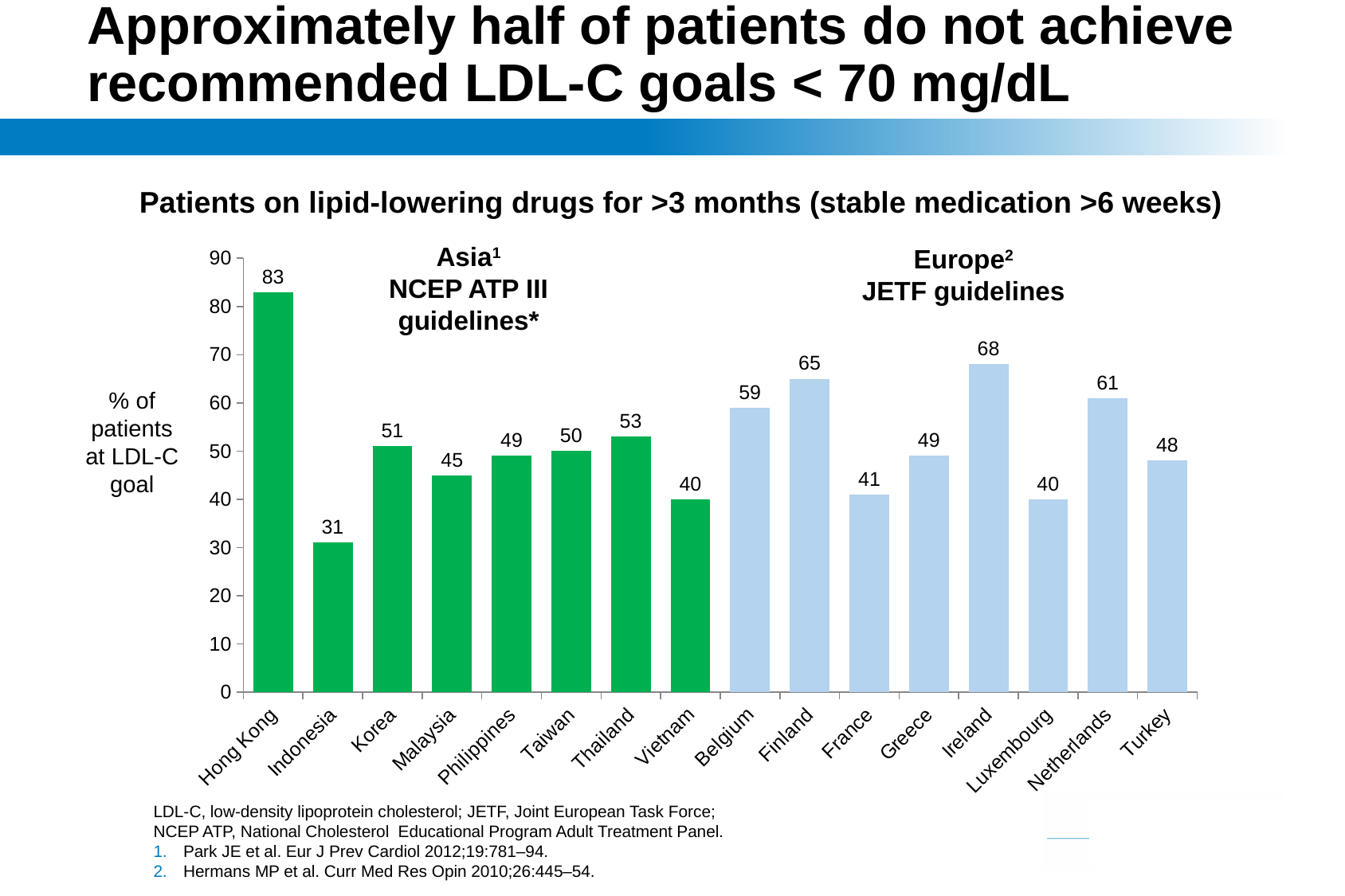
What is the label on the y axis of the chart? % of patients at LDL-C goal What is the difference between the values for Hong Kong and Indonesia? 52 What is the value for Ireland? 68 What is the difference between the values for Finland and France? 24 How many countries are shown on the chart? 16 What is the value for Hong Kong? 83 Which country has the highest percentage of patients at LDL-C goal? Hong Kong Which country has the lowest percentage of patients at LDL-C goal? Indonesia What kind of chart is shown on the slide? Bar chart What is the value for Indonesia? 31 Which is larger, the value for Netherlands or the value for Belgium? Netherlands Is the value for Turkey greater or less than 50? less